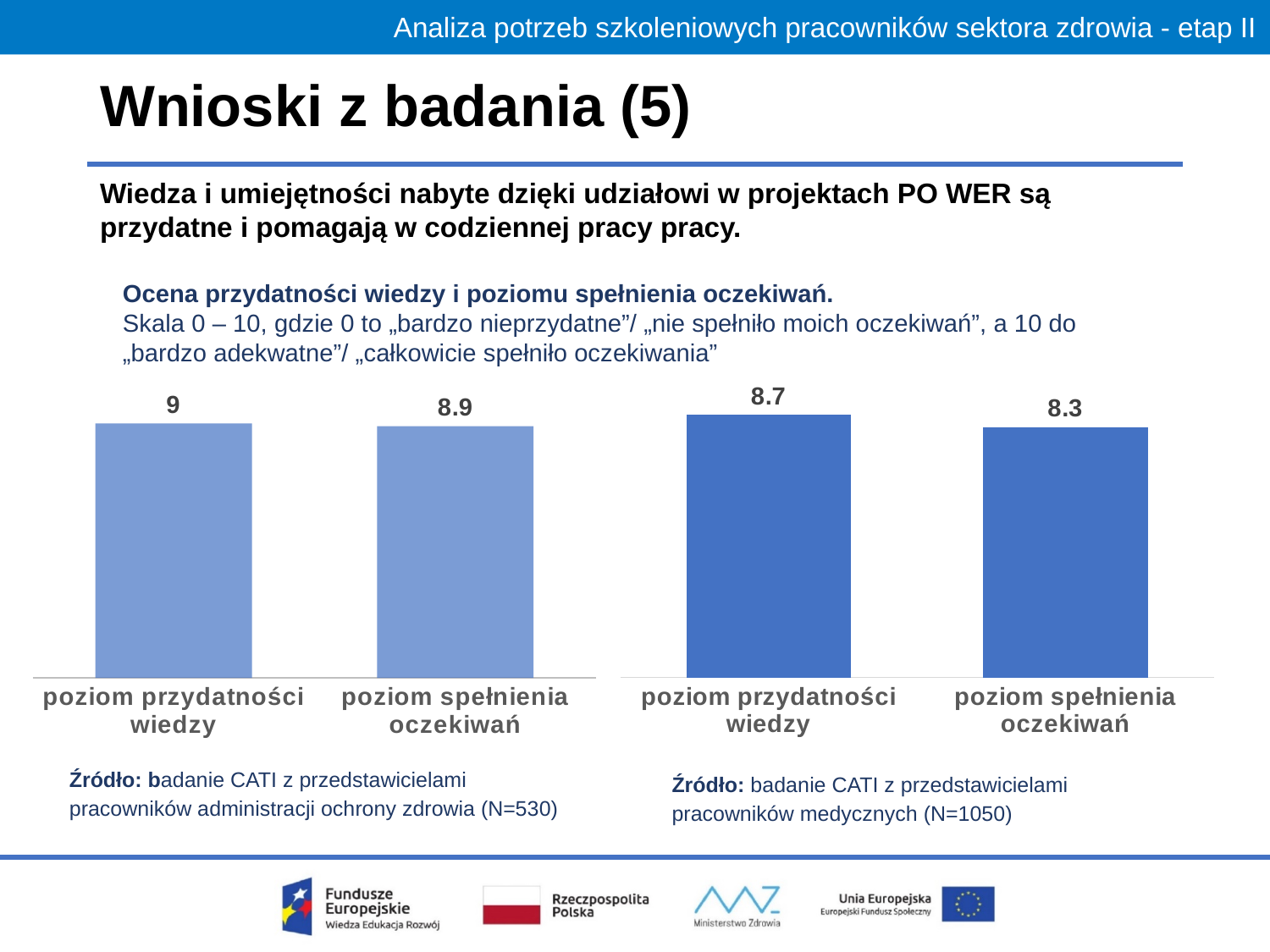
In the left chart (pracownicy administracji ochrony zdrowia), what is the value for "poziom spełnienia oczekiwań"? 8.9 Is the value for "poziom przydatności wiedzy" higher in the left chart (administracja) or in the right chart (pracownicy medyczni)? left chart (administracja) In the left chart (pracownicy administracji ochrony zdrowia), what is the value for "poziom przydatności wiedzy"? 9 In the left chart (pracownicy administracji ochrony zdrowia), what is the difference between "poziom przydatności wiedzy" and "poziom spełnienia oczekiwań"? 0.1 In the right chart (pracownicy medyczni), which category has the lower value? poziom spełnienia oczekiwań In the right chart (pracownicy medyczni), which category has the higher value? poziom przydatności wiedzy What type of chart is used on the slide? bar chart How many bars does the left chart (pracownicy administracji ochrony zdrowia) show? 2 What is the sample size (N) given in the source note for the right chart (pracownicy medyczni)? N=1050 In the right chart (pracownicy medyczni), what is the difference between "poziom przydatności wiedzy" and "poziom spełnienia oczekiwań"? 0.4 In the right chart (pracownicy medyczni), what is the value for "poziom spełnienia oczekiwań"? 8.3 In the right chart (pracownicy medyczni), what is the value for "poziom przydatności wiedzy"? 8.7